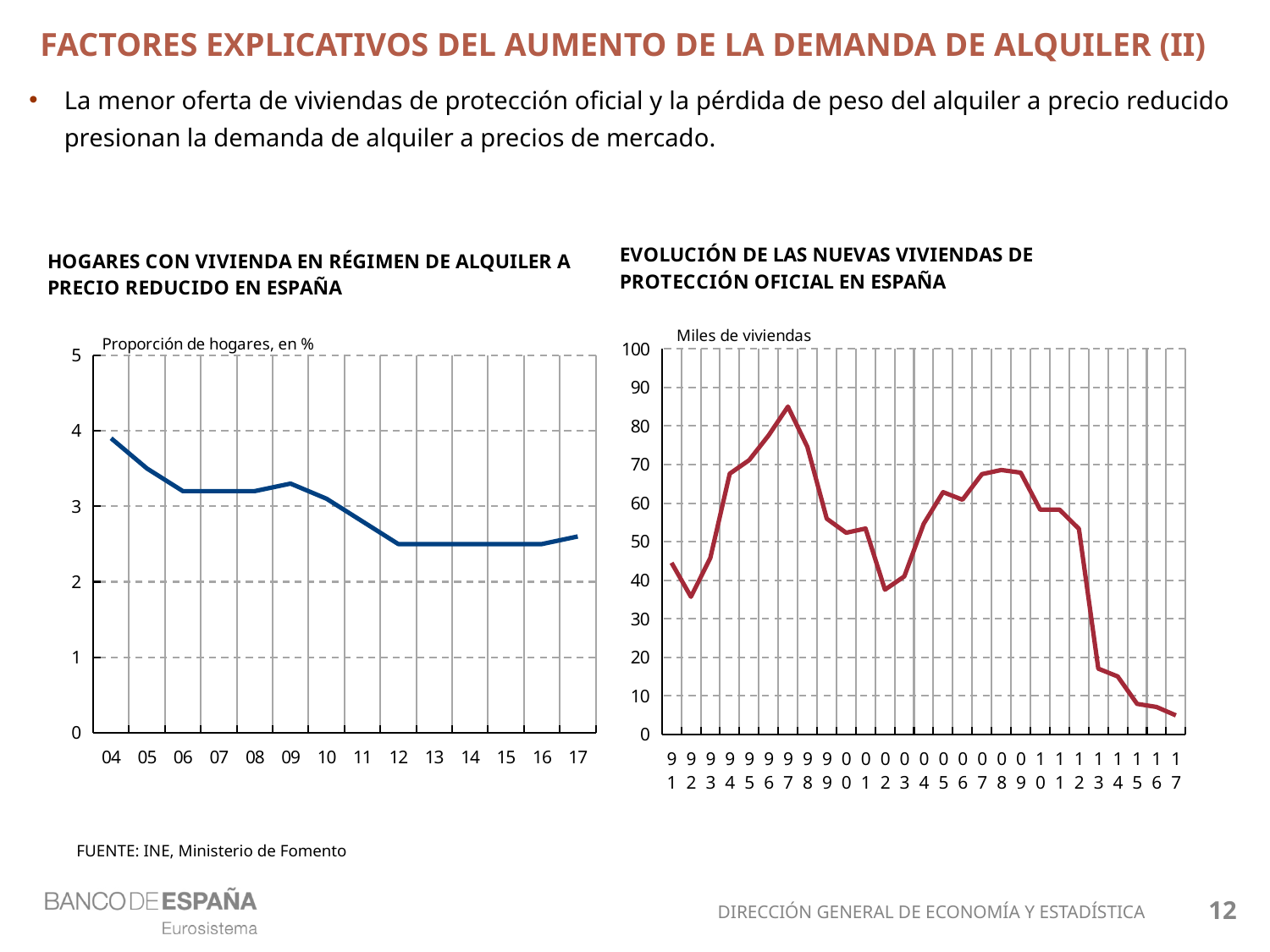
What kind of chart is the left chart, 'Hogares con vivienda en régimen de alquiler a precio reducido en España'? Line chart In the right chart, how many years are shown on the x axis? 27 In the right chart, is the value for 13 greater or less than 20? less What kind of chart is the right chart, 'Evolución de las nuevas viviendas de protección oficial en España'? Line chart In the right chart, which year has the highest number of new protected housing units? 97 In the left chart, is the value for 04 greater or less than 3? greater In the left chart, how many years are shown on the x axis? 14 In the right chart, what unit is indicated on the y axis label? Miles de viviendas In the left chart, which year has the highest proportion of households? 04 In the right chart, which year has the lowest value? 17 In the right chart, is the value for 97 greater or less than 80? greater